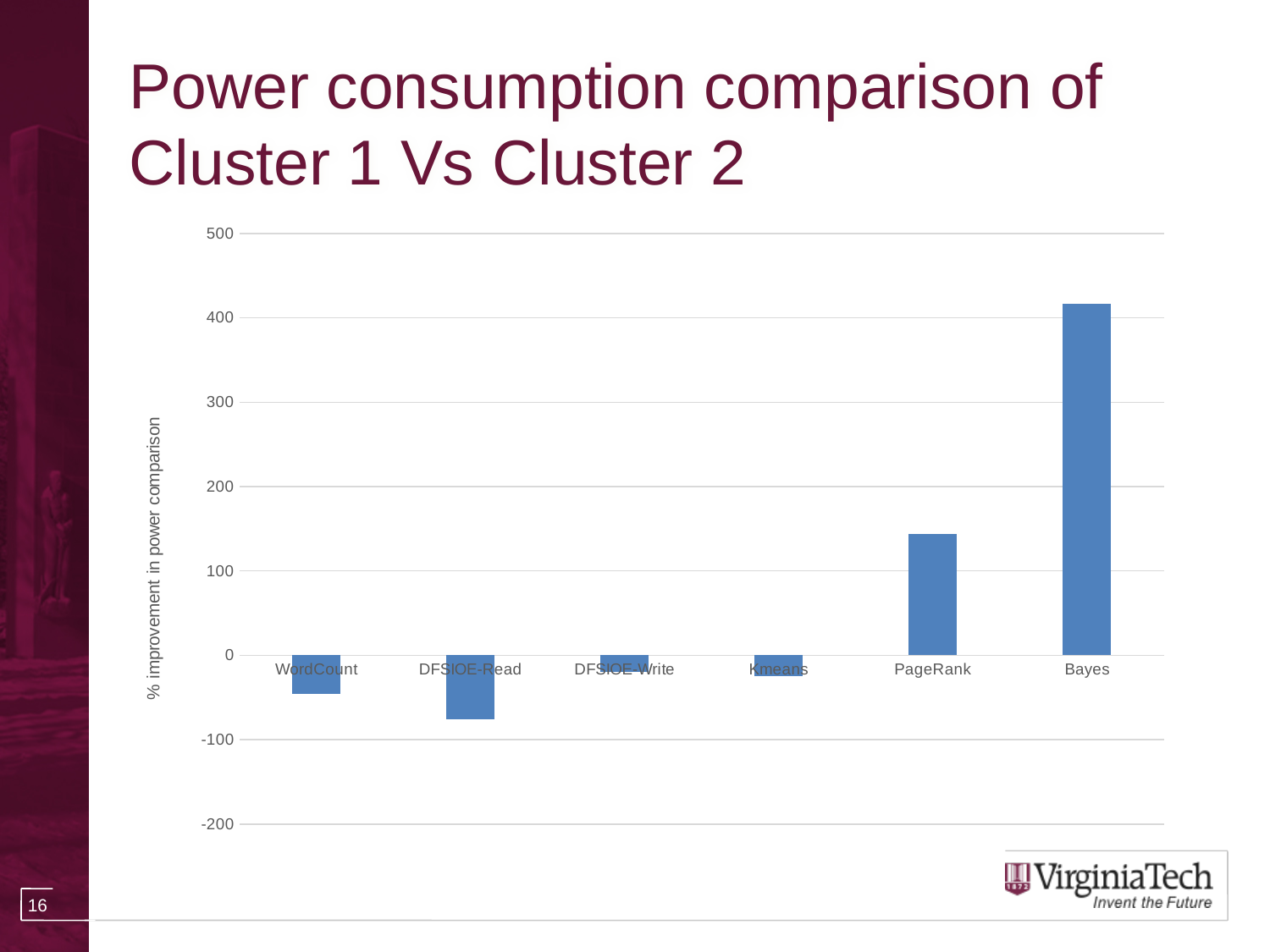
What kind of chart is shown on the slide? bar chart Which workload has the highest % improvement in power comparison? Bayes Which workload has the lowest % improvement in power comparison? DFSIOE-Read Which is larger, the value for PageRank or the value for Bayes? Bayes How many categories (workloads) are plotted on the x axis? 6 Is the value for PageRank greater or less than 200? less Is the value for WordCount greater or less than -100? greater Is the value for Bayes greater or less than 400? greater What is the label on the vertical axis of the chart? % improvement in power comparison Which is larger, the value for WordCount or the value for DFSIOE-Read? WordCount